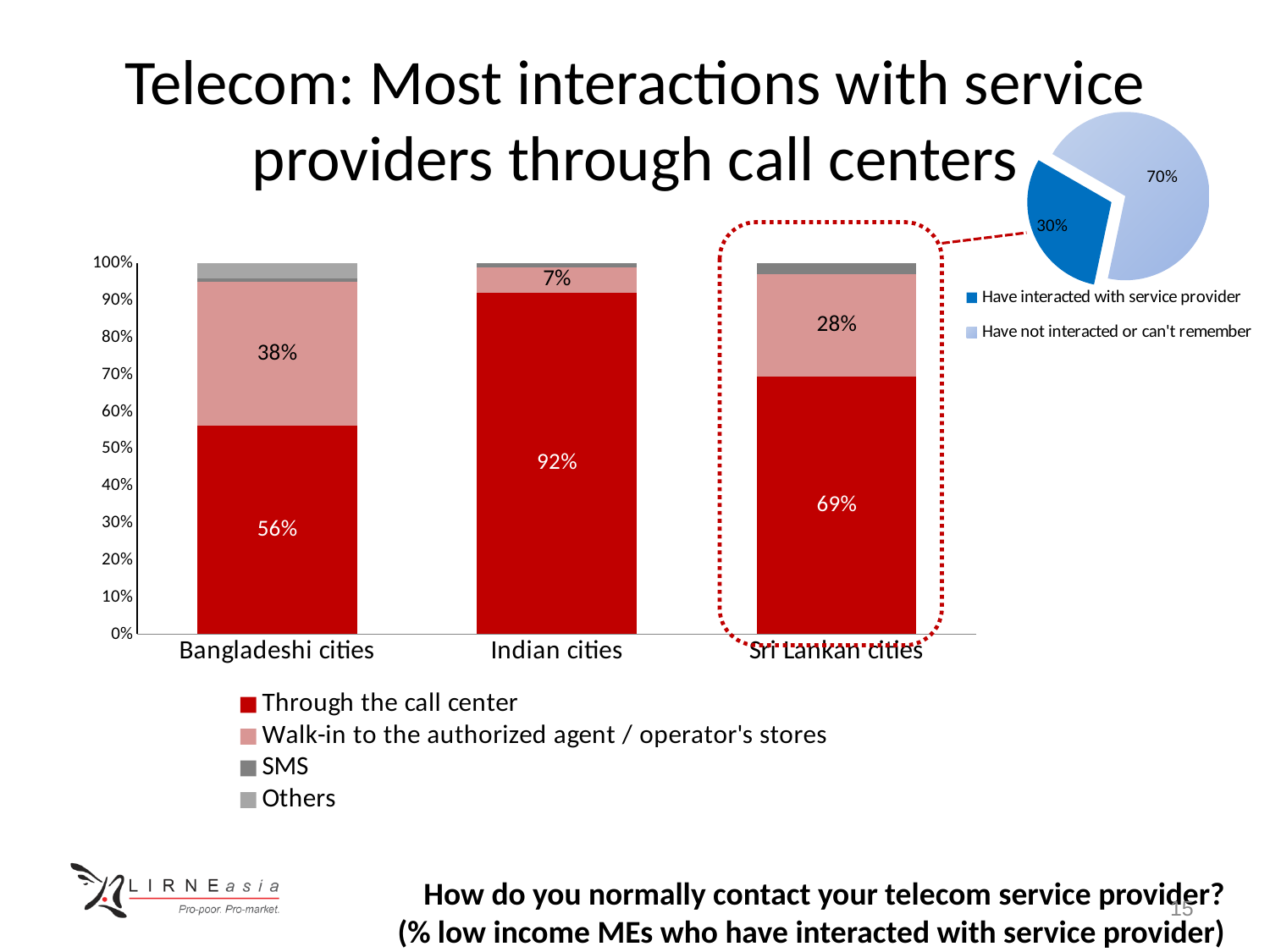
How many series does the legend of the stacked bar chart list? 4 In the stacked bar chart, what is the value for walk-in to the authorized agent / operator's stores in Sri Lankan cities? 28% In the pie chart at the top right, which slice is the largest? Have not interacted or can't remember In the stacked bar chart, what is the difference between the call center share in Indian cities and in Bangladeshi cities? 36 percentage points How many city groups are shown on the x axis of the stacked bar chart? 3 In the stacked bar chart, which city group has the highest share contacting through the call center? Indian cities In the pie chart at the top right, what share have interacted with the service provider? 30% What kind of chart is the large chart on the left of the slide? Stacked bar chart In the stacked bar chart, which city group has the lowest share contacting through the call center? Bangladeshi cities In the stacked bar chart, what percentage of respondents in Bangladeshi cities contact their provider through the call center? 56% In the stacked bar chart, what is the walk-in value for Indian cities? 7% In the stacked bar chart, which has a larger walk-in share: Bangladeshi cities or Sri Lankan cities? Bangladeshi cities